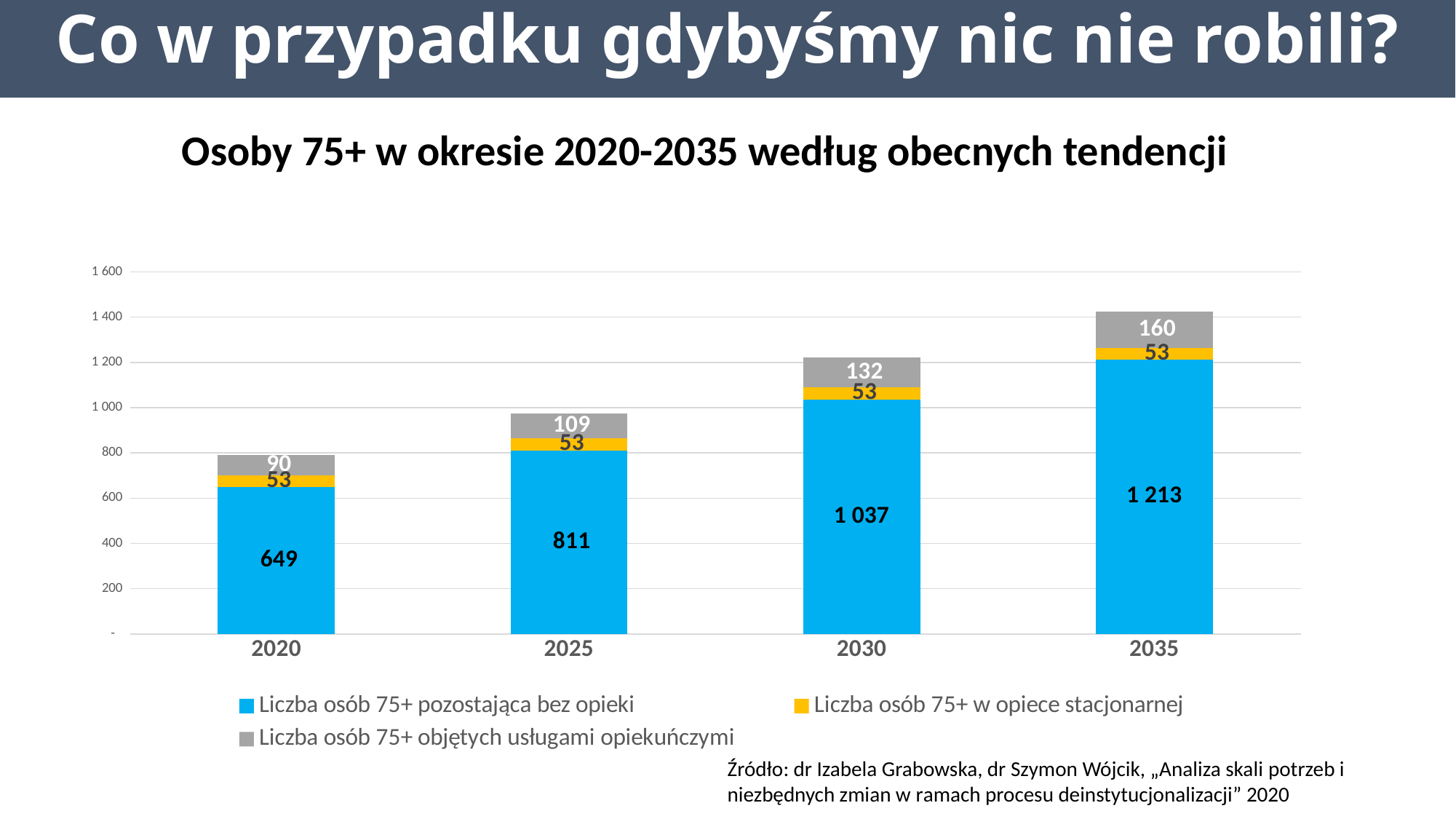
What is the value for 'Liczba osób 75+ pozostająca bez opieki' in 2030? 1 037 What is the value for 'Liczba osób 75+ w opiece stacjonarnej' in 2025? 53 What is the total of the stacked bar for 2035? 1 426 What is the difference between the 'Liczba osób 75+ pozostająca bez opieki' values for 2035 and 2020? 564 What is the value for 'Liczba osób 75+ objętych usługami opiekuńczymi' in 2035? 160 Does the value for 'Liczba osób 75+ pozostająca bez opieki' rise or fall from 2020 to 2035? rise Which is larger: 'Liczba osób 75+ objętych usługami opiekuńczymi' in 2025 or in 2030? 2030 How many series does the legend list? 3 How many years are shown on the x axis? 4 In which year is the value for 'Liczba osób 75+ pozostająca bez opieki' the highest? 2035 What is the total of the stacked bar for 2020? 792 In which year is the value for 'Liczba osób 75+ objętych usługami opiekuńczymi' the lowest? 2020